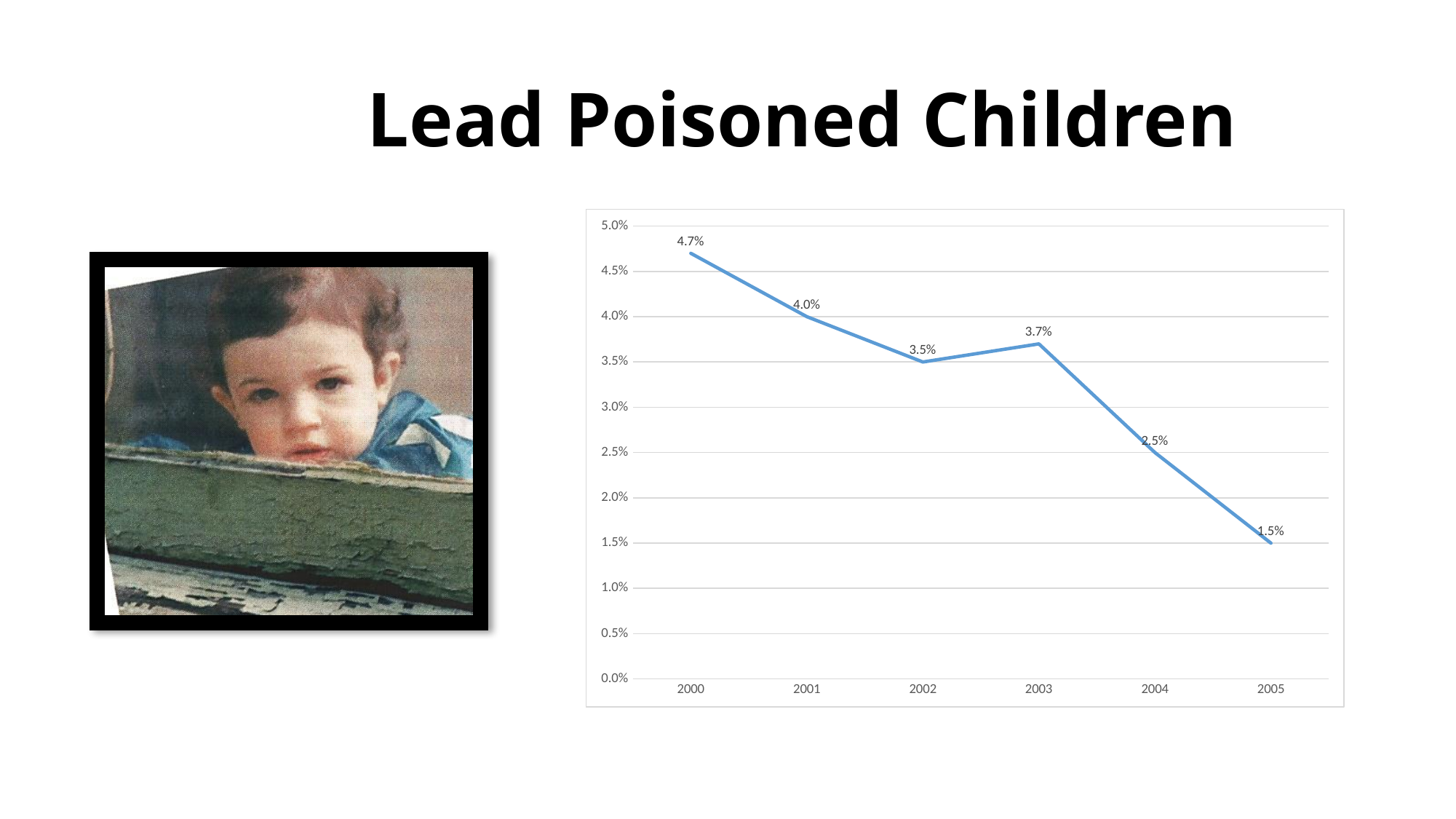
What is the value for 2003? 3.7% What is the difference between the values for 2002 and 2003? 0.2% What is the difference between the values for 2000 and 2005? 3.2% Is the value for 2004 greater or less than 3.0%? less How many years are plotted on the chart? 6 Which year has the highest value? 2000 What is the value for 2000? 4.7% What kind of chart is shown on the slide? line chart Which year has the lowest value? 2005 Which is larger, the value for 2001 or the value for 2004? 2001 Do the values generally rise or fall from 2000 to 2005? fall What is the value for 2005? 1.5%